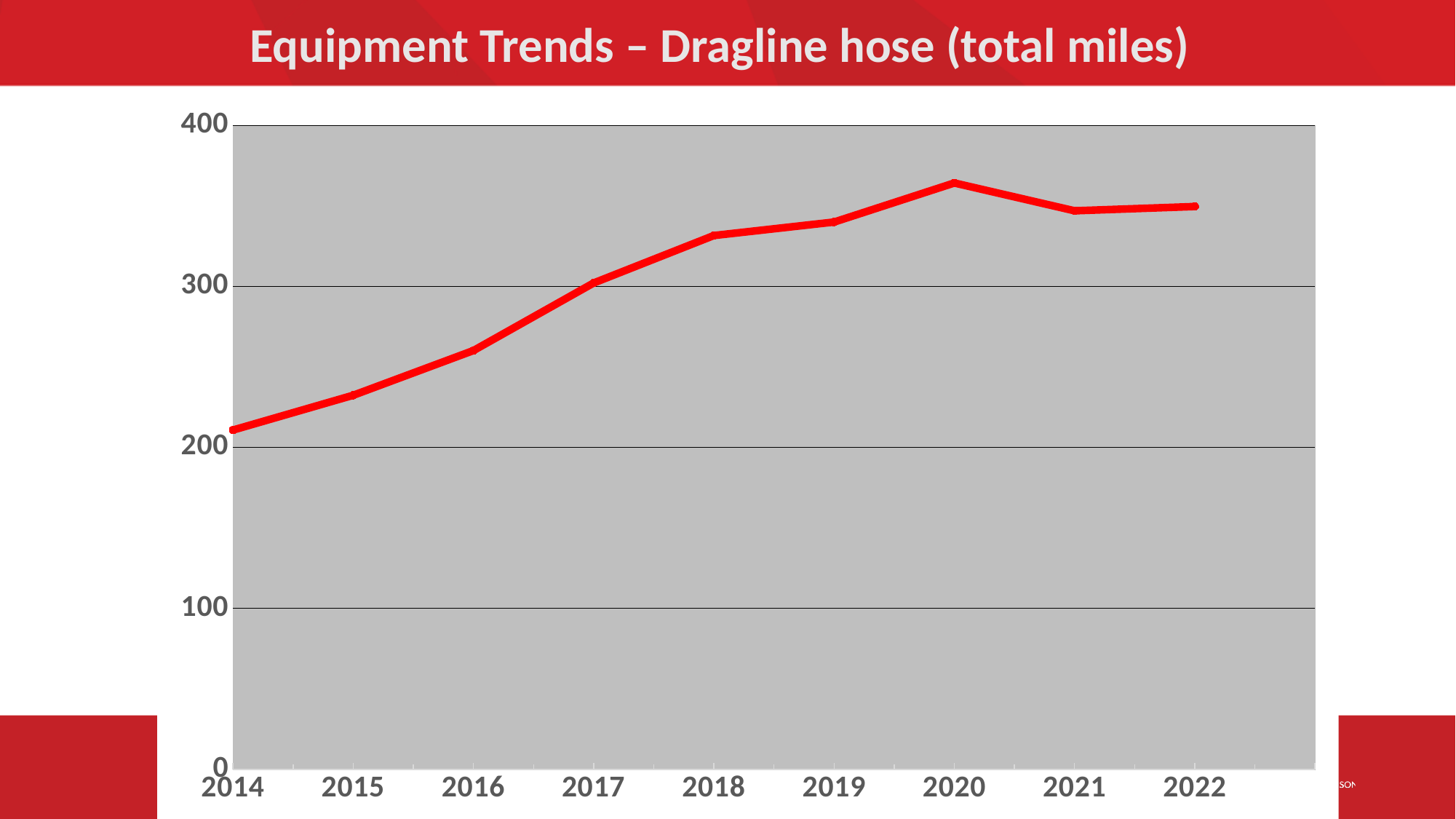
Which year has the larger value, 2015 or 2017? 2017 What is the title of the slide? Equipment Trends – Dragline hose (total miles) Is the value for 2014 greater or less than 200? greater Is the value for 2016 greater or less than 300? less How many years are plotted along the x axis? 9 Is the value for 2020 greater or less than 400? less Which year has the larger value, 2020 or 2021? 2020 In which year is the dragline hose total miles highest? 2020 What kind of chart is shown on the slide? line chart Do the values generally rise or fall from 2014 to 2020? rise In which year is the dragline hose total miles lowest? 2014